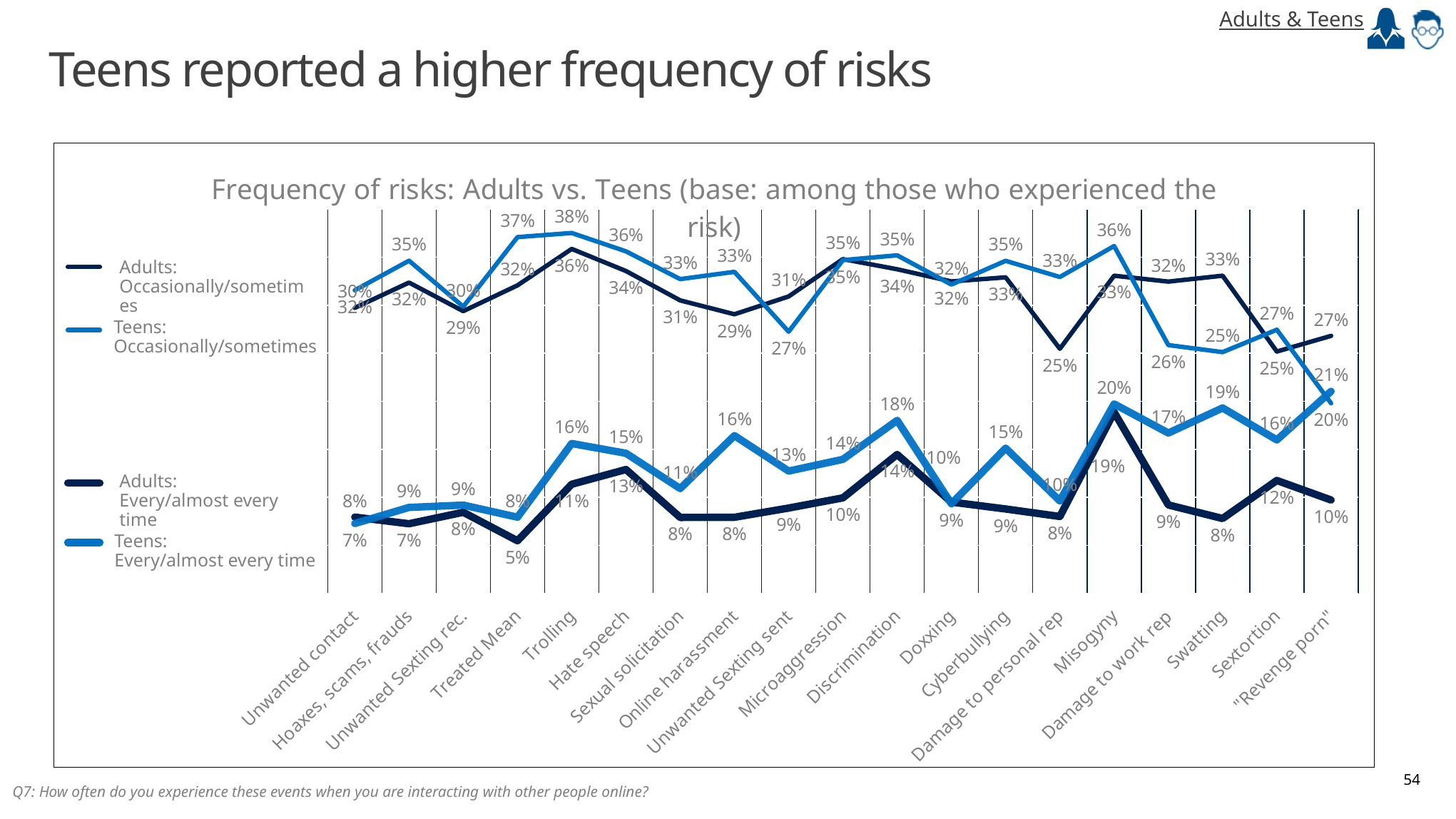
What is the title of the chart? Frequency of risks: Adults vs. Teens (base: among those who experienced the risk) What kind of chart is shown on the slide? line chart How many series does the legend list? 4 What is the value for Teens: Occasionally/sometimes for Trolling? 38% Which category has the highest value for Teens: Occasionally/sometimes? Trolling How many risk categories are plotted along the x axis? 19 What is the difference between Teens: Every/almost every time and Adults: Every/almost every time for Swatting? 11% For Sextortion, which is larger: Teens: Occasionally/sometimes or Adults: Occasionally/sometimes? Teens: Occasionally/sometimes Which category has the lowest value for Adults: Every/almost every time? Treated Mean What is the value for Adults: Occasionally/sometimes for Damage to personal rep? 25% What is the value for Teens: Every/almost every time for Trolling? 16% What is the value for Adults: Every/almost every time for Misogyny? 19%